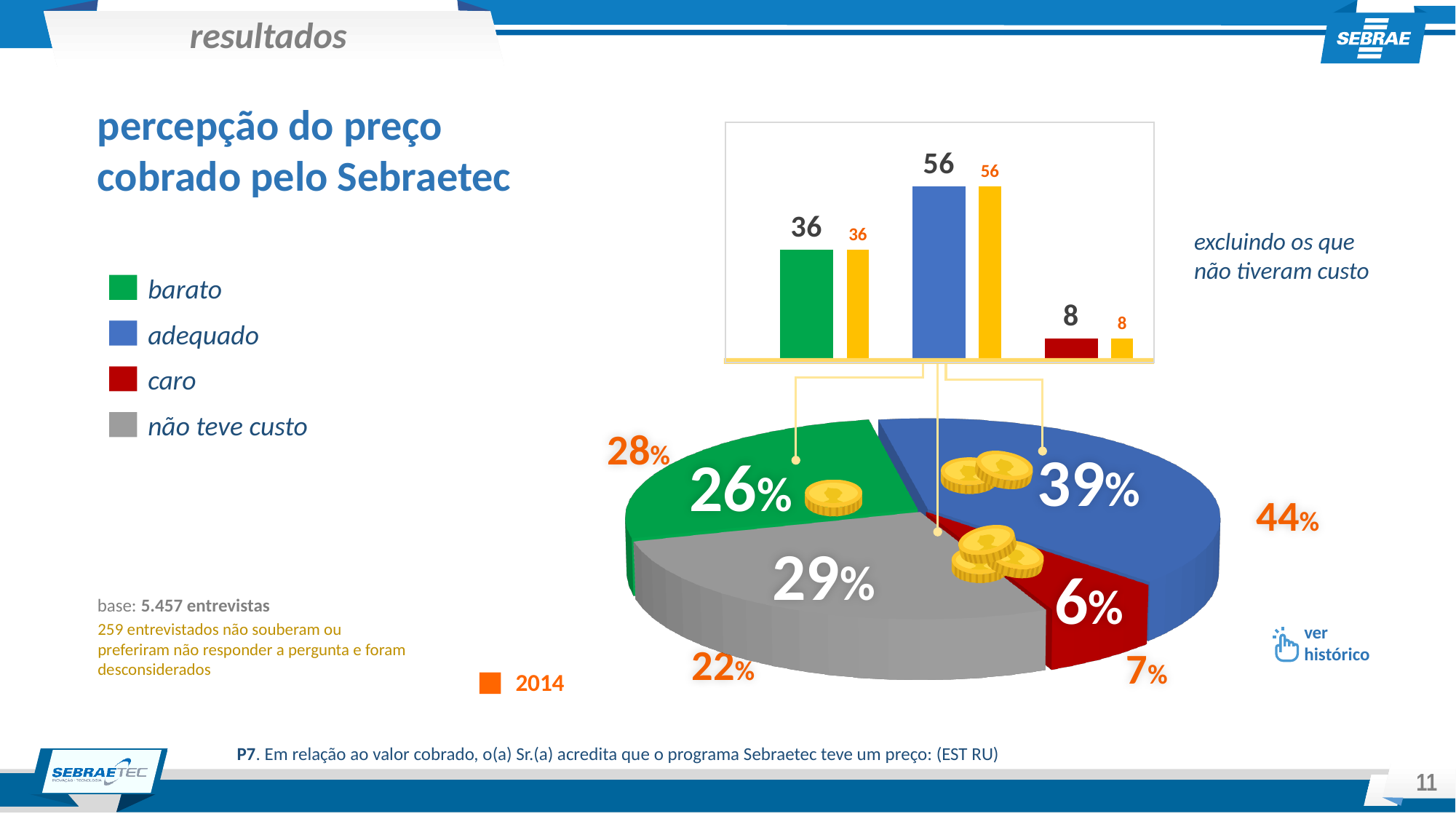
In the pie chart, how many slices are there? 4 In the pie chart, what share is shown for the 'adequado' slice? 39% In the pie chart, what share is shown for the 'não teve custo' slice? 29% In the pie chart, what share is shown for the 'caro' slice? 6% In the bar chart at the top (excluding those with no cost), what is the value of the blue 'adequado' bar? 56 In the pie chart, which category has the largest slice? adequado What type of chart is the large chart in the lower part of the slide? pie chart In the bar chart at the top, what is the value of the red 'caro' bar? 8 In the bar chart at the top, what is the difference between the 'adequado' value and the 'caro' value? 48 In the pie chart, which category has the smallest slice? caro In the bar chart at the top, what is the value of the green 'barato' bar? 36 In the pie chart, what is the difference between the 'adequado' share and the 'barato' share? 13%